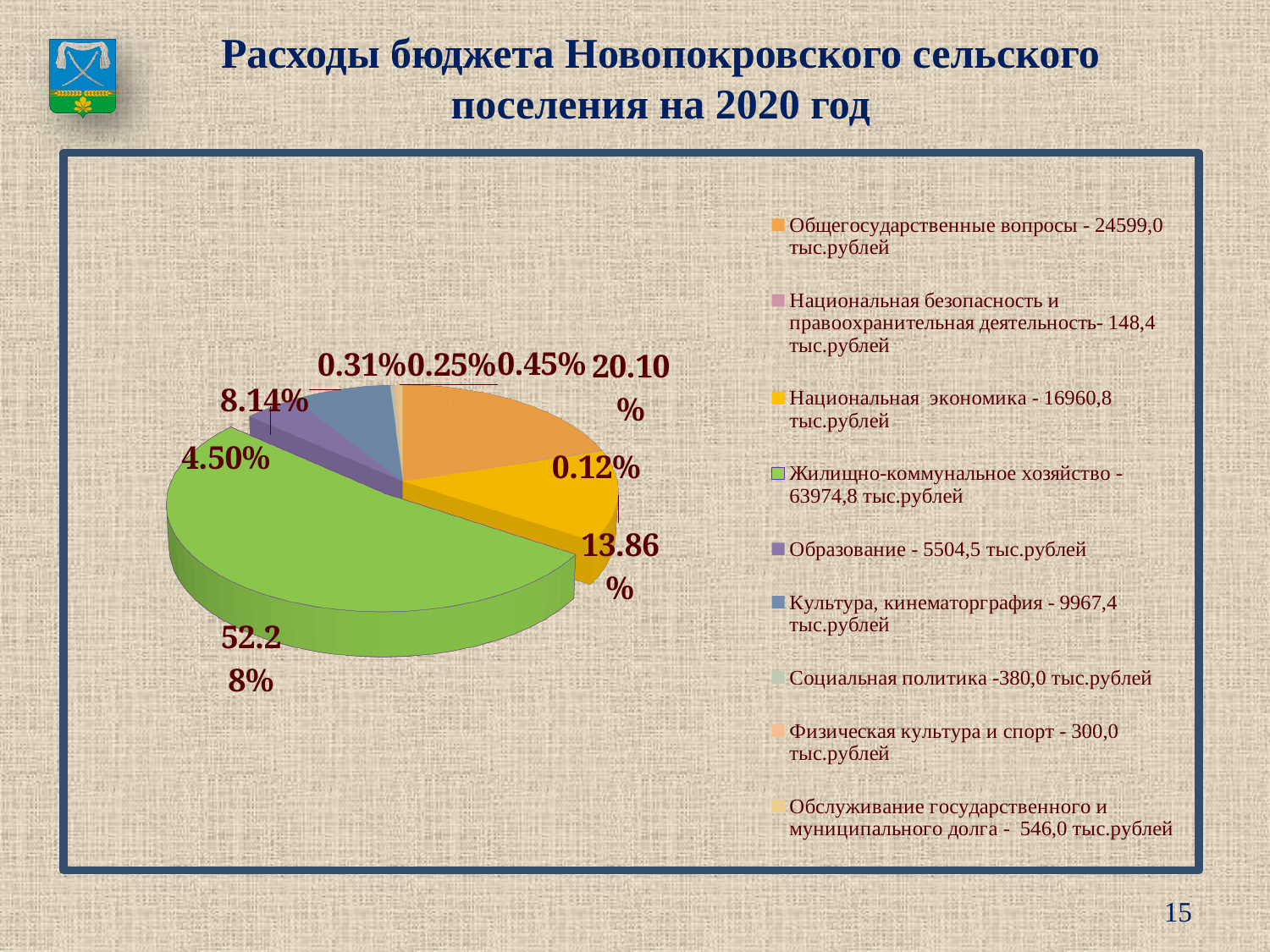
What amount in тыс.рублей does the legend give for Национальная экономика? 16960,8 тыс.рублей What kind of chart is shown on the slide? pie chart Which category has the smallest share of the pie chart? Национальная безопасность и правоохранительная деятельность How many categories does the legend of the pie chart list? 9 What is the title of the slide containing the pie chart? Расходы бюджета Новопокровского сельского поселения на 2020 год What is the difference in percentage points between the shares of Общегосударственные вопросы and Национальная экономика? 6.24 What share of the pie does Общегосударственные вопросы have? 20.10% What share of the pie does Культура, кинематорграфия have? 8.14% What share of the pie does Жилищно-коммунальное хозяйство have? 52.28% What amount in тыс.рублей does the legend give for Образование? 5504,5 тыс.рублей Which has a larger share of the pie: Образование or Культура, кинематорграфия? Культура, кинематорграфия Which category has the largest share of the pie chart? Жилищно-коммунальное хозяйство